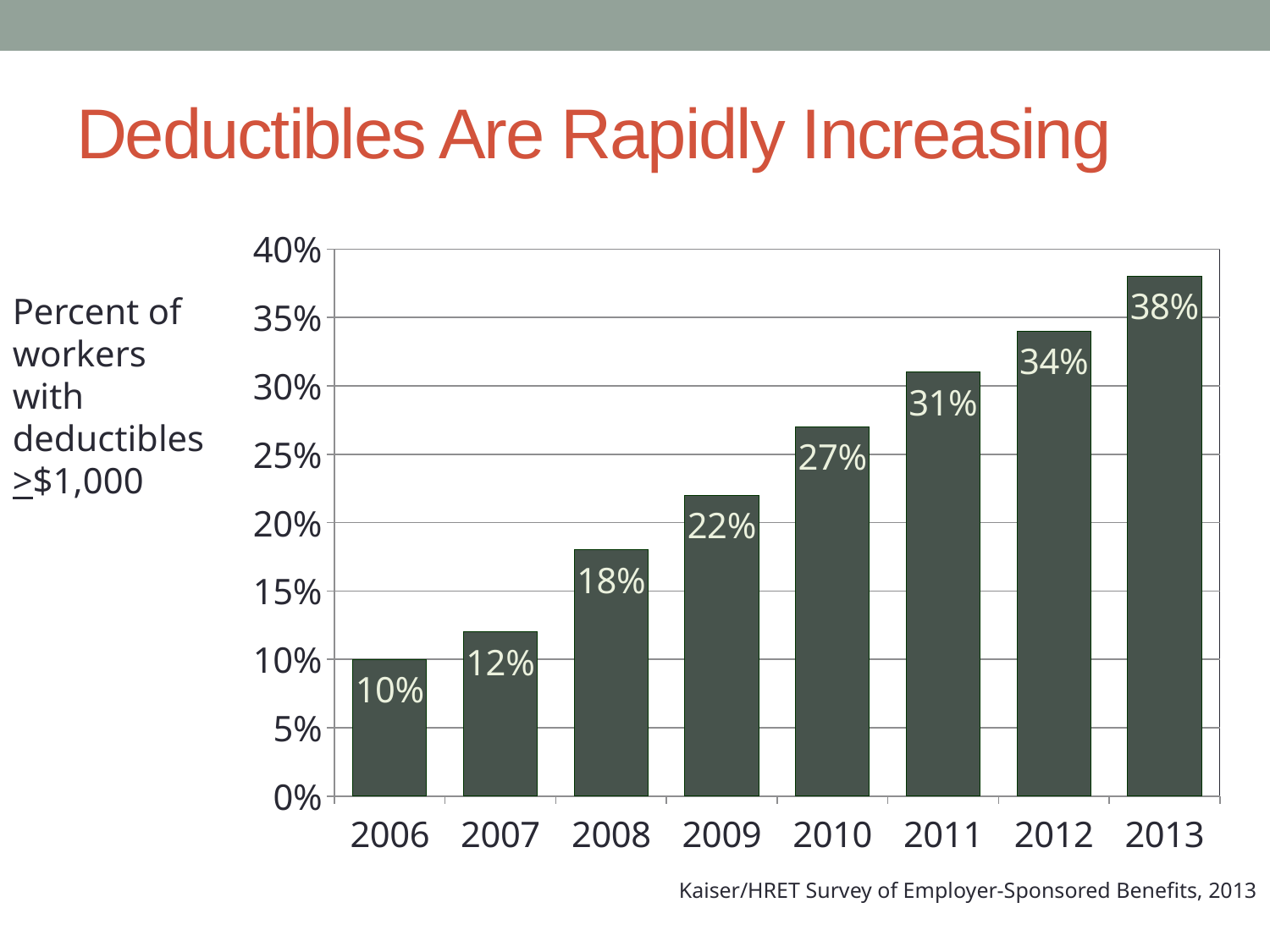
Which year has the highest value? 2013 What is the difference between the values for 2013 and 2006? 28% Is the value for 2008 greater or less than 20%? less What percent of workers had deductibles of $1,000 or more in 2010? 27% What kind of chart is shown on the slide? bar chart What is the value shown for 2006? 10% How many years are shown on the x axis? 8 What is the value shown for 2012? 34% Which is larger, the value for 2011 or the value for 2009? 2011 What is the difference between the values for 2009 and 2008? 4% Which year has the lowest value? 2006 Do the values rise or fall from 2006 to 2013? rise